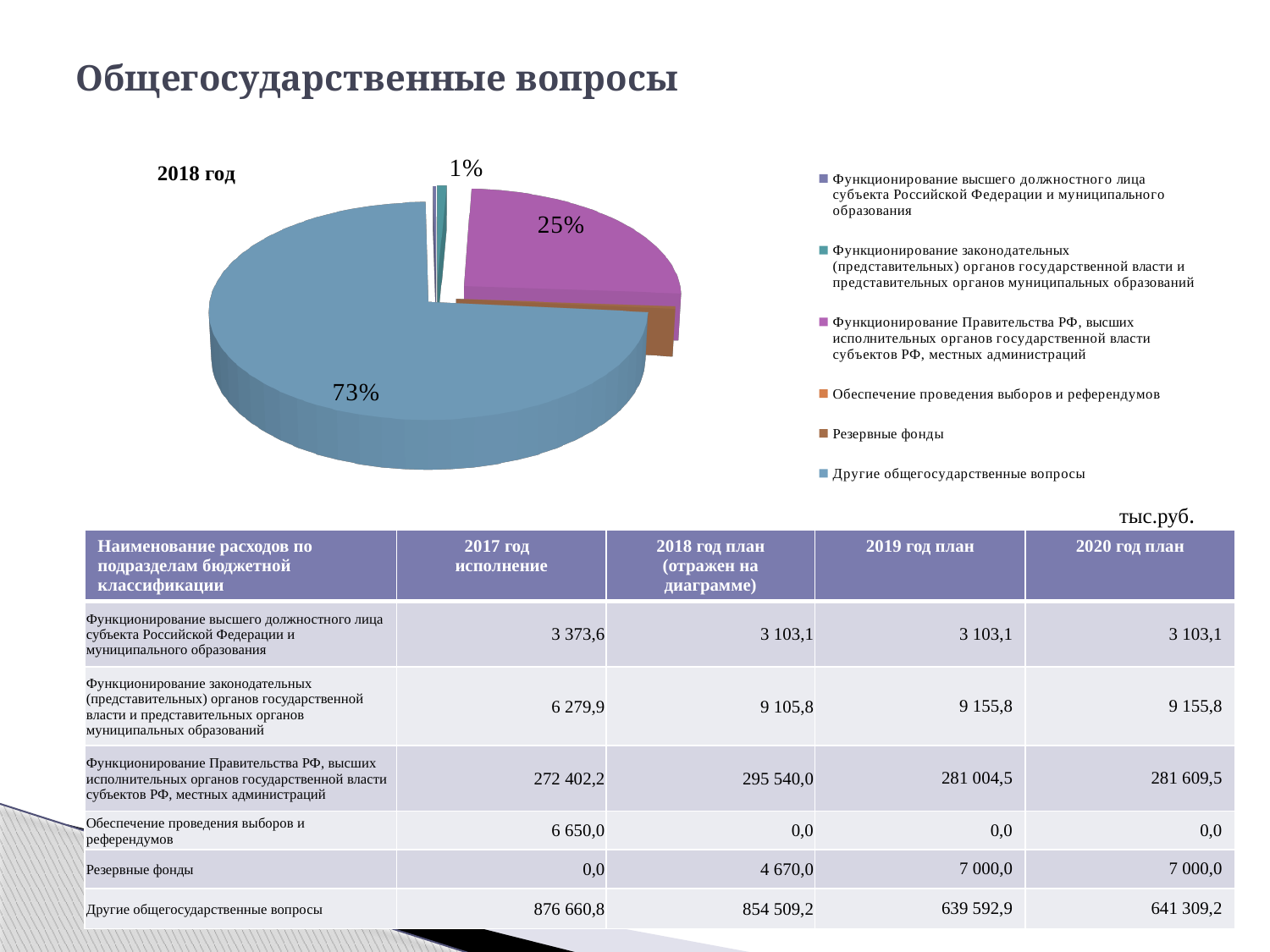
By how many percentage points does the 73% slice exceed the 25% slice? 48 How many percentage data labels are printed on the pie chart? 3 Which category has the largest slice in the pie chart? Другие общегосударственные вопросы What share of the pie does the slice for "Функционирование Правительства РФ, высших исполнительных органов государственной власти субъектов РФ, местных администраций" represent? 25% What is the smallest percentage printed as a data label on the pie chart? 1% How many entries does the pie chart's legend list? 6 What kind of chart is shown on the slide? pie chart What share of the pie does the slice for "Другие общегосударственные вопросы" represent? 73% What colour is the largest slice of the pie chart? blue Which slice is larger: "Другие общегосударственные вопросы" or "Функционирование Правительства РФ, высших исполнительных органов государственной власти субъектов РФ, местных администраций"? Другие общегосударственные вопросы What is the title of the pie chart? 2018 год Is the share of "Другие общегосударственные вопросы" greater or less than 50%? greater